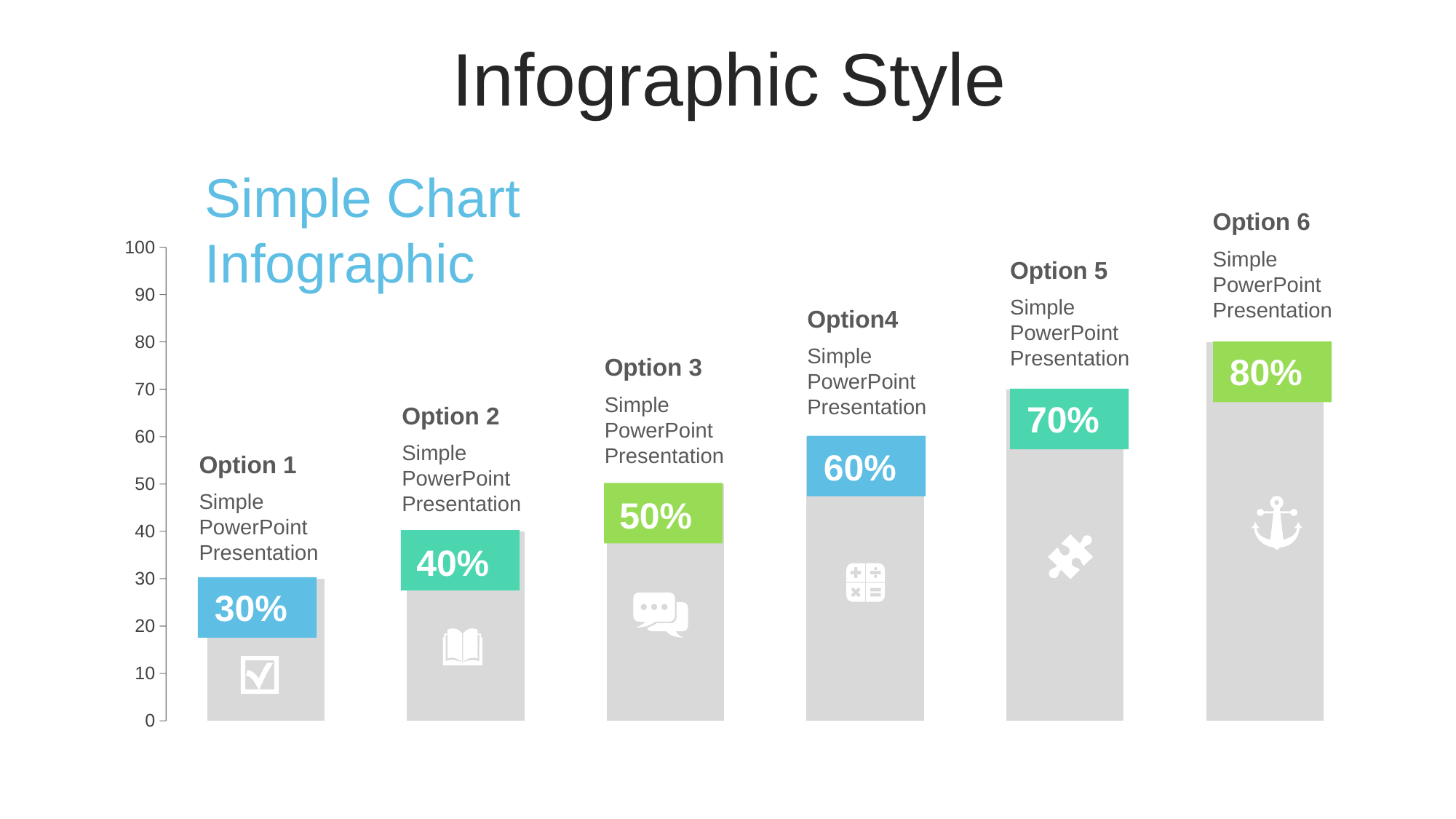
What is the value shown for Option 6? 80% What is the difference between the values for Option 5 and Option 2? 30% Which option has the highest value? Option 6 Do the values rise or fall from Option 1 to Option 6? Rise Which is larger, the value for Option 3 or the value for Option 5? Option 5 What is the value shown for Option 4? 60% Which option has the lowest value? Option 1 How many options (bars) are shown in the chart? 6 Is the value for Option 4 greater or less than 50? greater What is the value shown for Option 1? 30% What is the difference between the values for Option 6 and Option 3? 30% What kind of chart is shown on the slide? Bar chart